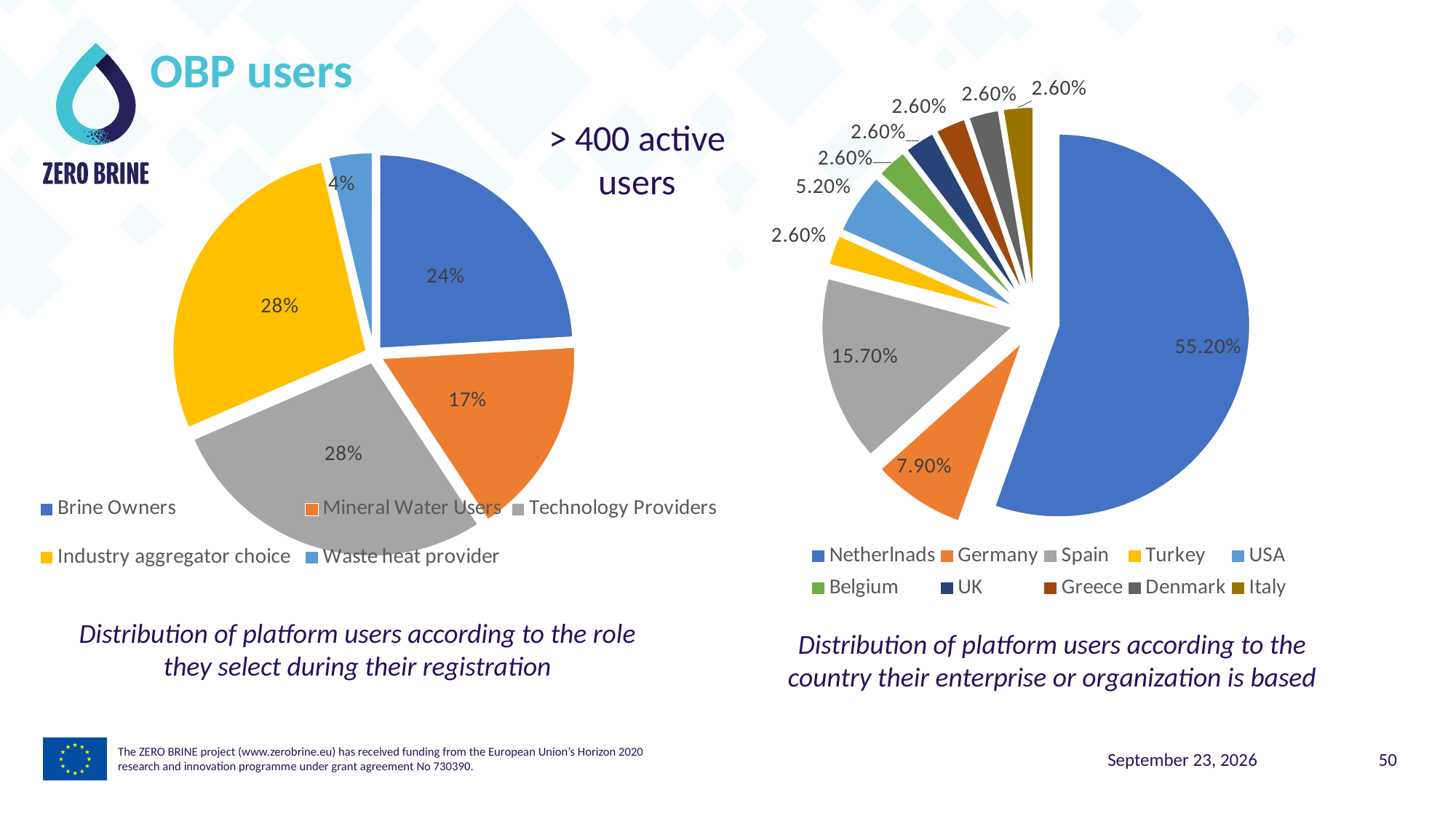
How many categories does the legend of the left pie chart (distribution by role) list? 5 In the left pie chart (distribution by role), what share of users are Brine Owners? 24% In the right pie chart (distribution by country), what share of users are based in Spain? 15.70% In the left pie chart (distribution by role), which is larger: Brine Owners or Mineral Water Users? Brine Owners In the left pie chart (distribution by role), what is the difference in percentage points between Technology Providers and Mineral Water Users? 11 In the right pie chart (distribution by country), what share of users are based in Germany? 7.90% What type of chart is used for the distribution of platform users by country on the right? Pie chart In the left pie chart (distribution by role), which role has the smallest share? Waste heat provider In the right pie chart (distribution by country), what share of users are based in the USA? 5.20% In the left pie chart (distribution by role), what share of users are Mineral Water Users? 17% In the right pie chart (distribution by country), which is larger: Spain or Germany? Spain How many countries does the legend of the right pie chart (distribution by country) list? 10